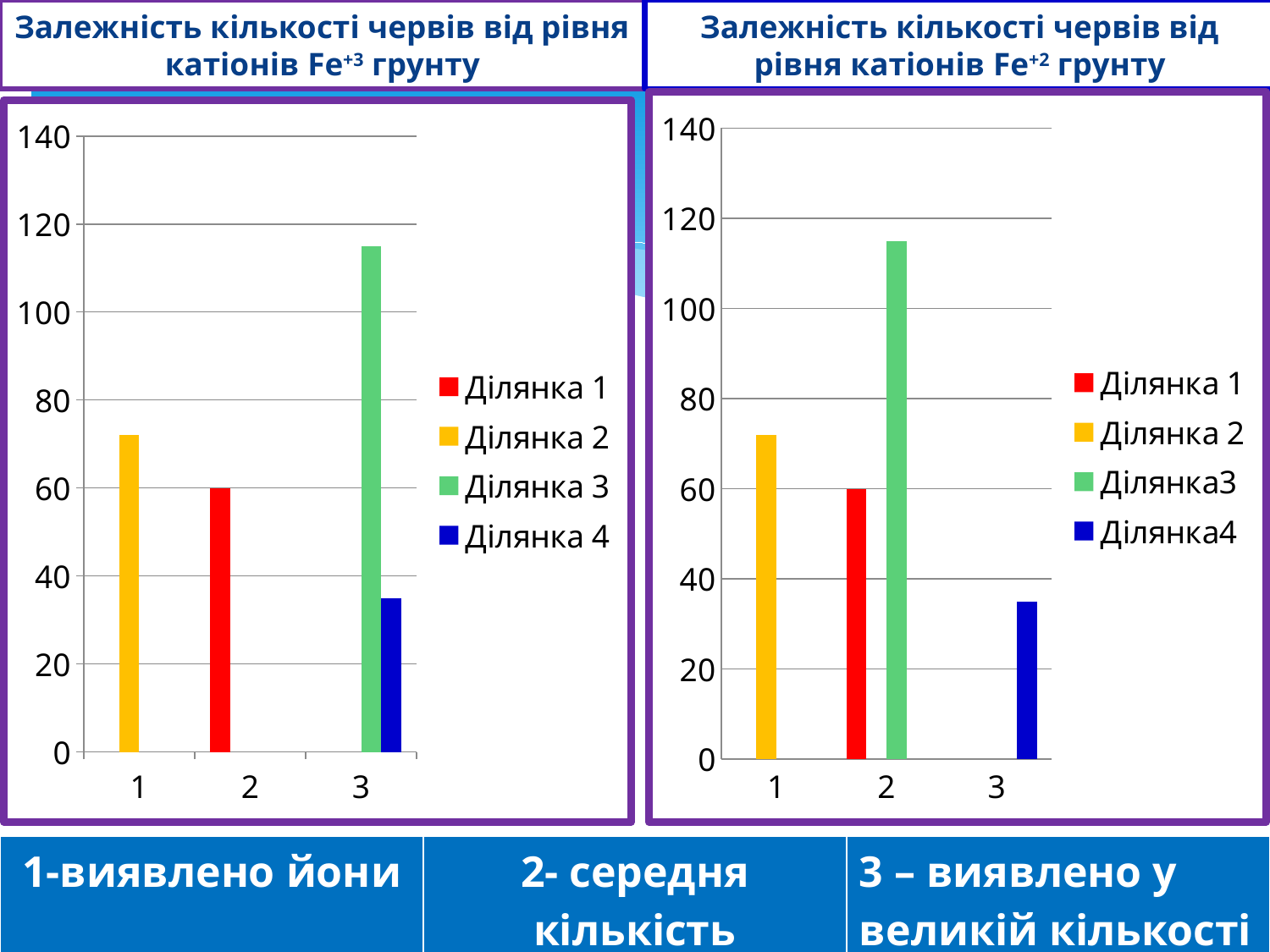
What colour is the bar for Ділянка 2 in the left chart (Fe+3)? yellow In the right chart (Fe+2), is the value for Ділянка4 greater or less than 40? less In the left chart (Fe+3), is the value for Ділянка 3 greater or less than 100? greater In the right chart (Fe+2), which is larger, the bar for Ділянка 2 or the bar for Ділянка 1? Ділянка 2 In the right chart (Fe+2), which series has the shortest bar? Ділянка4 What kind of chart is the left chart, titled 'Залежність кількості червів від рівня катіонів Fe+3 грунту'? bar chart In the left chart (Fe+3), what value does the bar for Ділянка 1 reach? 60 How many categories are shown on the x axis of the right chart (Fe+2)? 3 In the left chart (Fe+3), which series has the tallest bar? Ділянка 3 In the right chart (Fe+2), at which x-axis category does the bar for Ділянка4 appear? 3 How many series does the legend of the left chart (Fe+3) list? 4 In the left chart (Fe+3), is the value for Ділянка 2 greater or less than 80? less